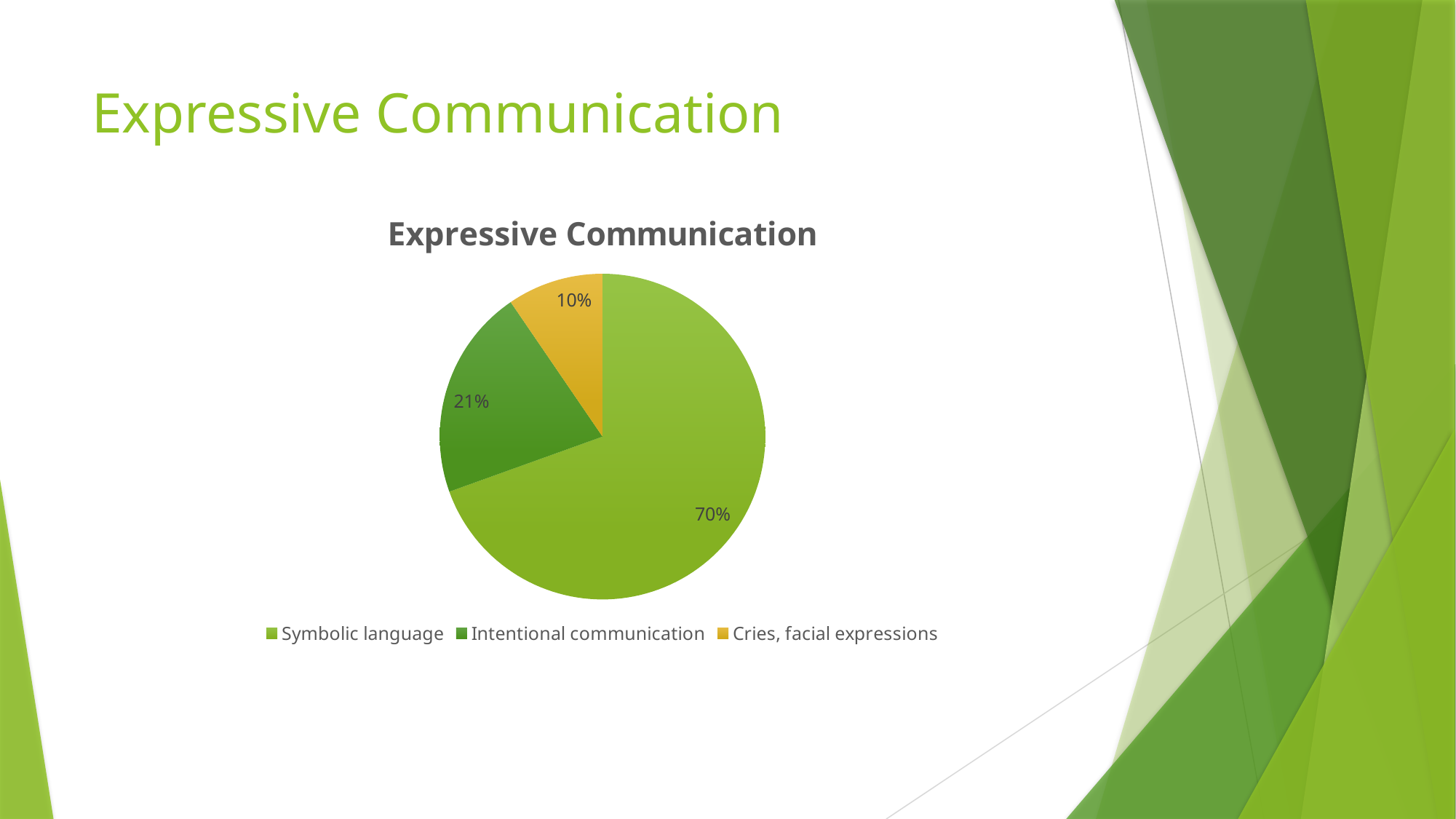
Which category has the smallest slice of the pie? Cries, facial expressions What is the title of the chart? Expressive Communication What share of the pie does Intentional communication take? 21% What kind of chart is shown on the slide? pie chart What share of the pie does Symbolic language take? 70% What share of the pie does Cries, facial expressions take? 10% Which is larger, the slice for Intentional communication or the slice for Cries, facial expressions? Intentional communication What colour is the slice for Cries, facial expressions? orange Which category has the largest slice of the pie? Symbolic language How many slices does the pie chart have? 3 How many entries does the legend list? 3 What is the difference in percentage points between Symbolic language and Intentional communication? 49